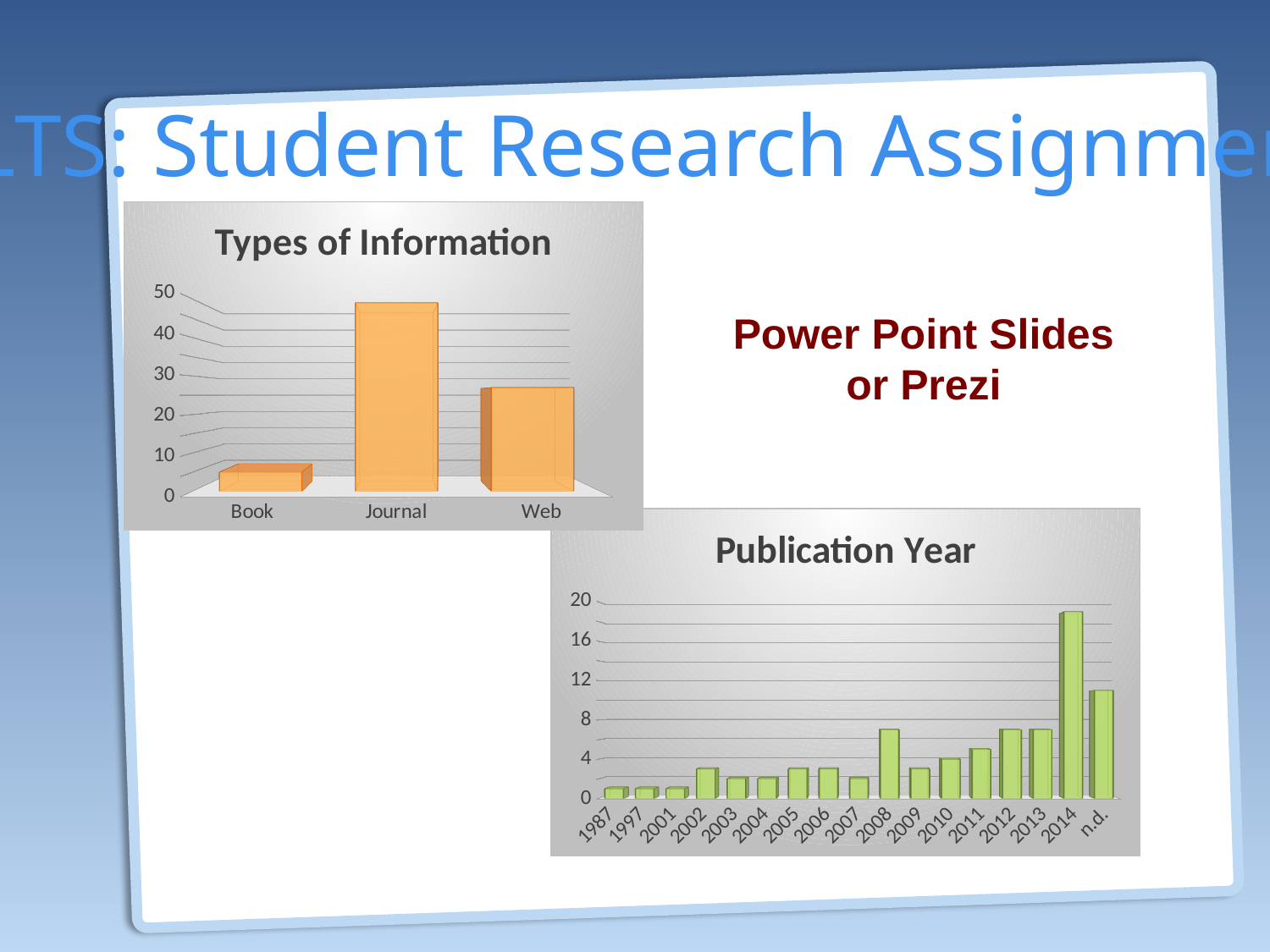
In the Publication Year chart, which category has the highest value? 2014 In the Publication Year chart, is the value for n.d. greater or less than 8? greater In the Types of Information chart, which category has the highest value? Journal In the Publication Year chart, is the value for 2014 greater or less than 16? greater How many categories are shown on the x axis of the Publication Year chart? 17 In the Publication Year chart, which is larger, the value for 2008 or the value for 2010? 2008 How many categories are shown in the Types of Information chart? 3 In the Types of Information chart, which is larger, the value for Web or the value for Book? Web In the Types of Information chart, is the value for Book greater or less than 10? less In the Types of Information chart, which category has the lowest value? Book What kind of chart is the Types of Information chart? Bar chart